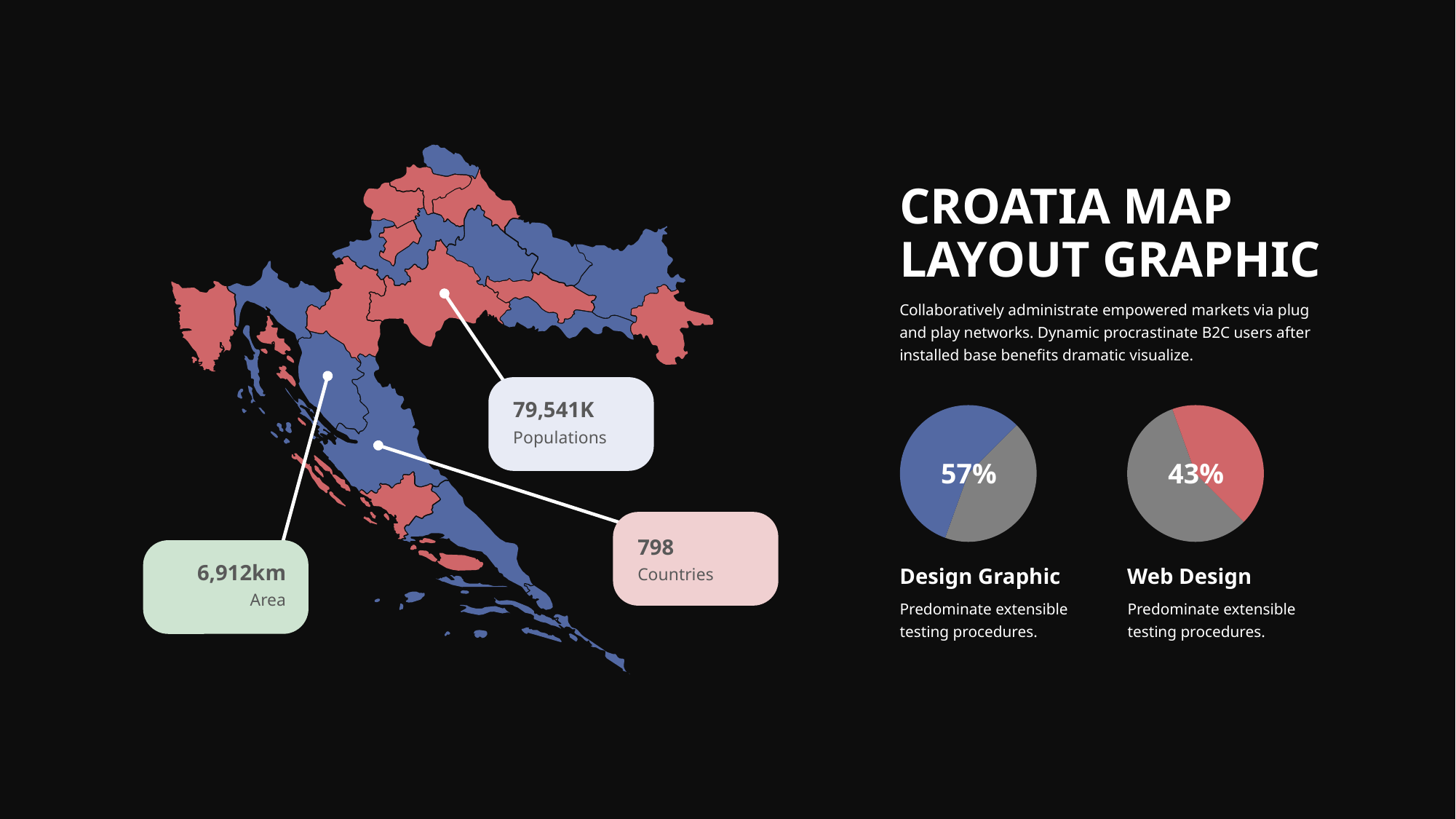
Is the percentage shown in the Design Graphic pie chart greater or less than 50%? greater In the Design Graphic pie chart, what percentage is shown? 57% In the Design Graphic pie chart, what share of the pie is the grey slice? 43% In the Web Design pie chart, what percentage is shown? 43% In the Web Design pie chart, what colour is the highlighted 43% slice? Red What kind of chart is used for Design Graphic and Web Design? Pie chart How many pie charts are on the slide? 2 In the Design Graphic pie chart, what colour is the highlighted 57% slice? Blue Which pie chart shows the larger percentage, Design Graphic or Web Design? Design Graphic Is the percentage shown in the Web Design pie chart greater or less than 50%? less What is the difference between the percentage shown in the Design Graphic pie chart and the percentage shown in the Web Design pie chart? 14 percentage points